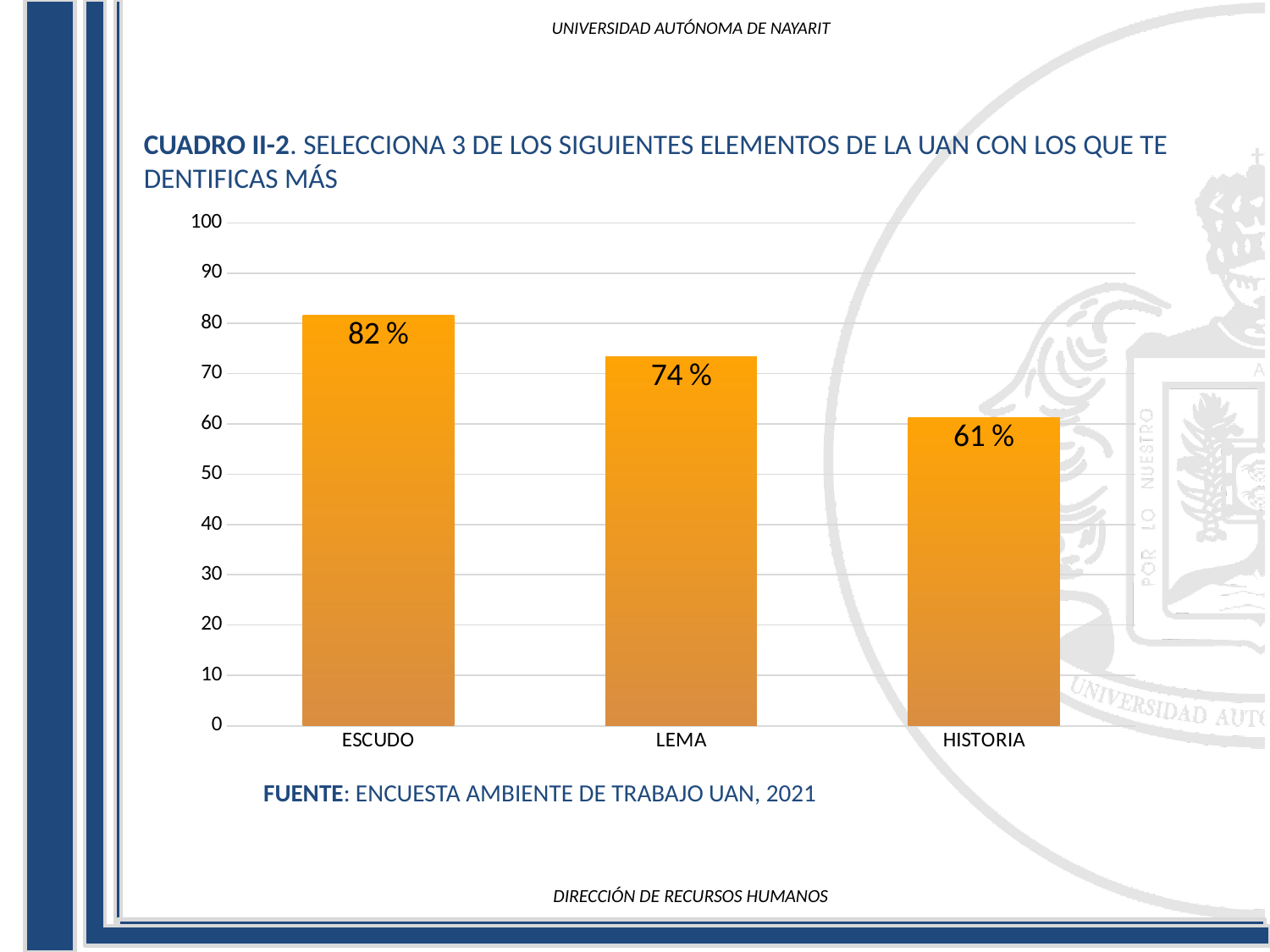
Do the values rise or fall from left to right along the x axis? fall What is the difference between the values for ESCUDO and HISTORIA? 21 % What is the value for HISTORIA? 61 % What is the value for LEMA? 74 % What kind of chart is shown on the slide? bar chart What is the difference between the values for ESCUDO and LEMA? 8 % How many categories are shown in the chart? 3 Is the value for HISTORIA greater or less than 70? less Which category has the lowest value? HISTORIA Which is larger, the value for LEMA or the value for HISTORIA? LEMA Which category has the highest value? ESCUDO What is the value for ESCUDO? 82 %